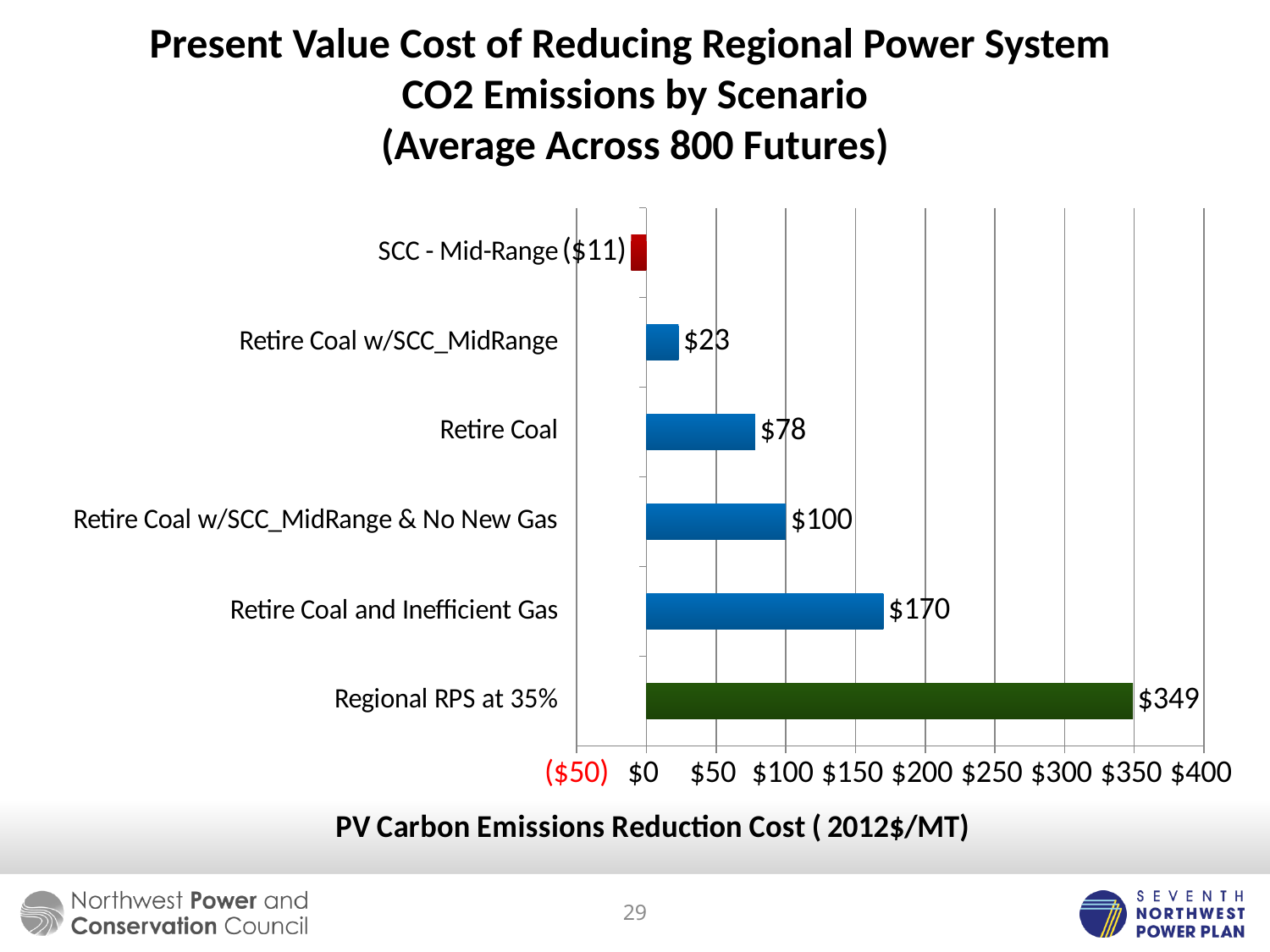
Which scenario has the highest PV carbon emissions reduction cost? Regional RPS at 35% How many scenarios are plotted in the chart? 6 What is the PV carbon emissions reduction cost for Regional RPS at 35%? $349 What is the value shown for SCC - Mid-Range? ($11) What is the x-axis title of the chart? PV Carbon Emissions Reduction Cost ( 2012$/MT) What kind of chart is shown on the slide? Bar chart What is the difference between the values for Retire Coal and Retire Coal w/SCC_MidRange? $55 What colour is the bar for Regional RPS at 35%? Green What is the value shown for Retire Coal and Inefficient Gas? $170 What is the value shown for Retire Coal w/SCC_MidRange & No New Gas? $100 Which scenario has the lowest PV carbon emissions reduction cost? SCC - Mid-Range Which has a larger value, Retire Coal and Inefficient Gas or Retire Coal? Retire Coal and Inefficient Gas